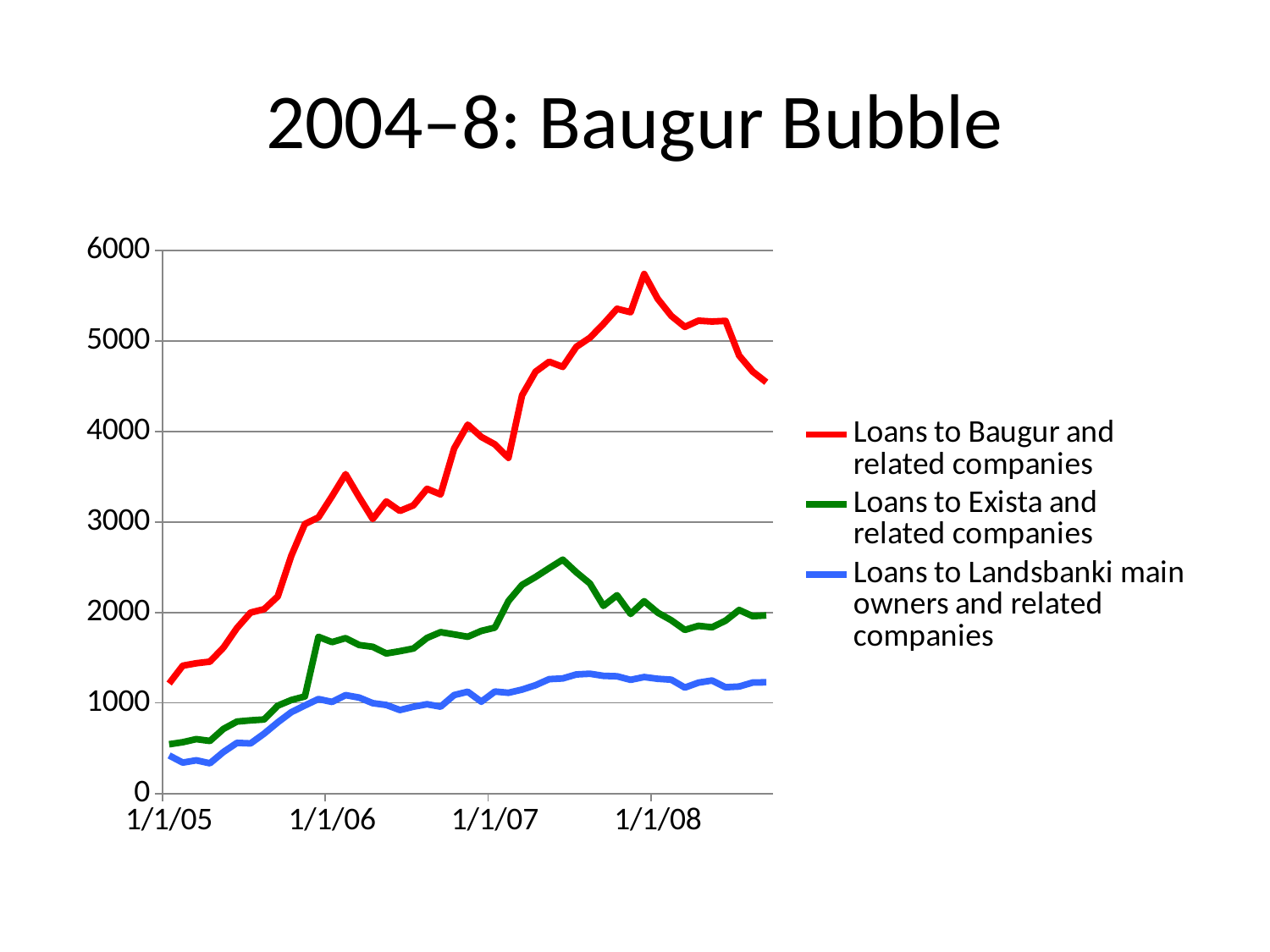
Which series stays lowest across the whole chart? Loans to Landsbanki main owners and related companies How many series does the legend list? 3 What is the title of the slide containing the chart? 2004–8: Baugur Bubble Is the value for Loans to Exista and related companies at 1/1/07 greater or less than 2000? less Do the values for Loans to Baugur and related companies rise or fall from 1/1/05 to 1/1/08? rise Is the value for Loans to Baugur and related companies at 1/1/08 greater or less than 5000? greater Which series reaches the highest value on the chart? Loans to Baugur and related companies Is the peak value for Loans to Baugur and related companies greater or less than 6000? less What kind of chart is shown on the slide? line chart At 1/1/07, which is larger: Loans to Baugur and related companies or Loans to Exista and related companies? Loans to Baugur and related companies Which series is drawn in red? Loans to Baugur and related companies